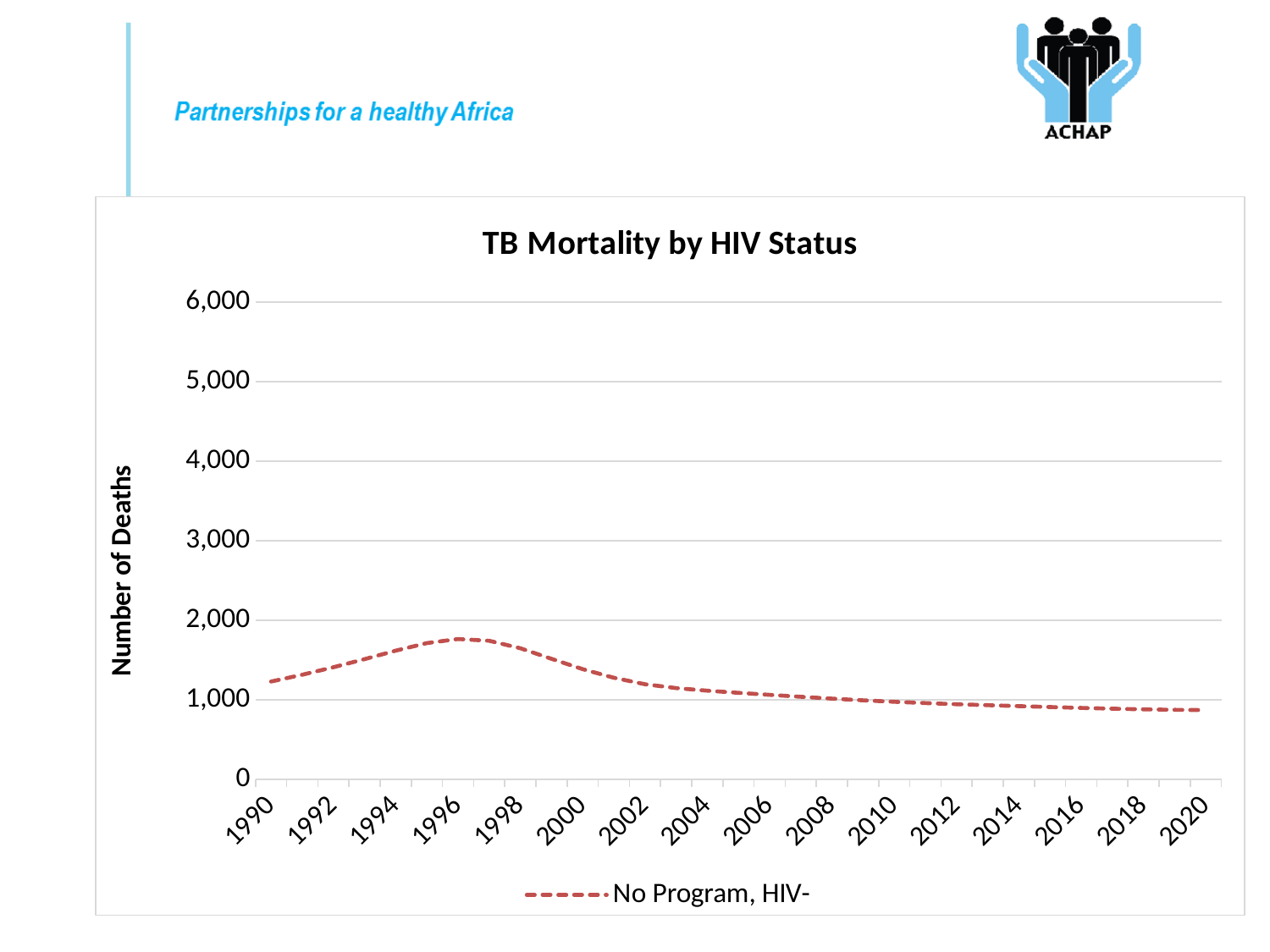
What kind of chart is shown on the slide? line chart Is the value for 1990 greater or less than 1,000? greater Which is larger, the value for 1990 or the value for 2020? 1990 What is the label of the series shown in the legend? No Program, HIV- How many year labels are shown on the x axis? 16 Do the values rise or fall from 1998 to 2020? fall Which is larger, the value for 1996 or the value for 2006? 1996 Which year has the lowest number of deaths? 2020 Is the value for 1996 greater or less than 2,000? less Is the value for 2020 greater or less than 1,000? less What is the title of the chart? TB Mortality by HIV Status How many series does the legend list? 1